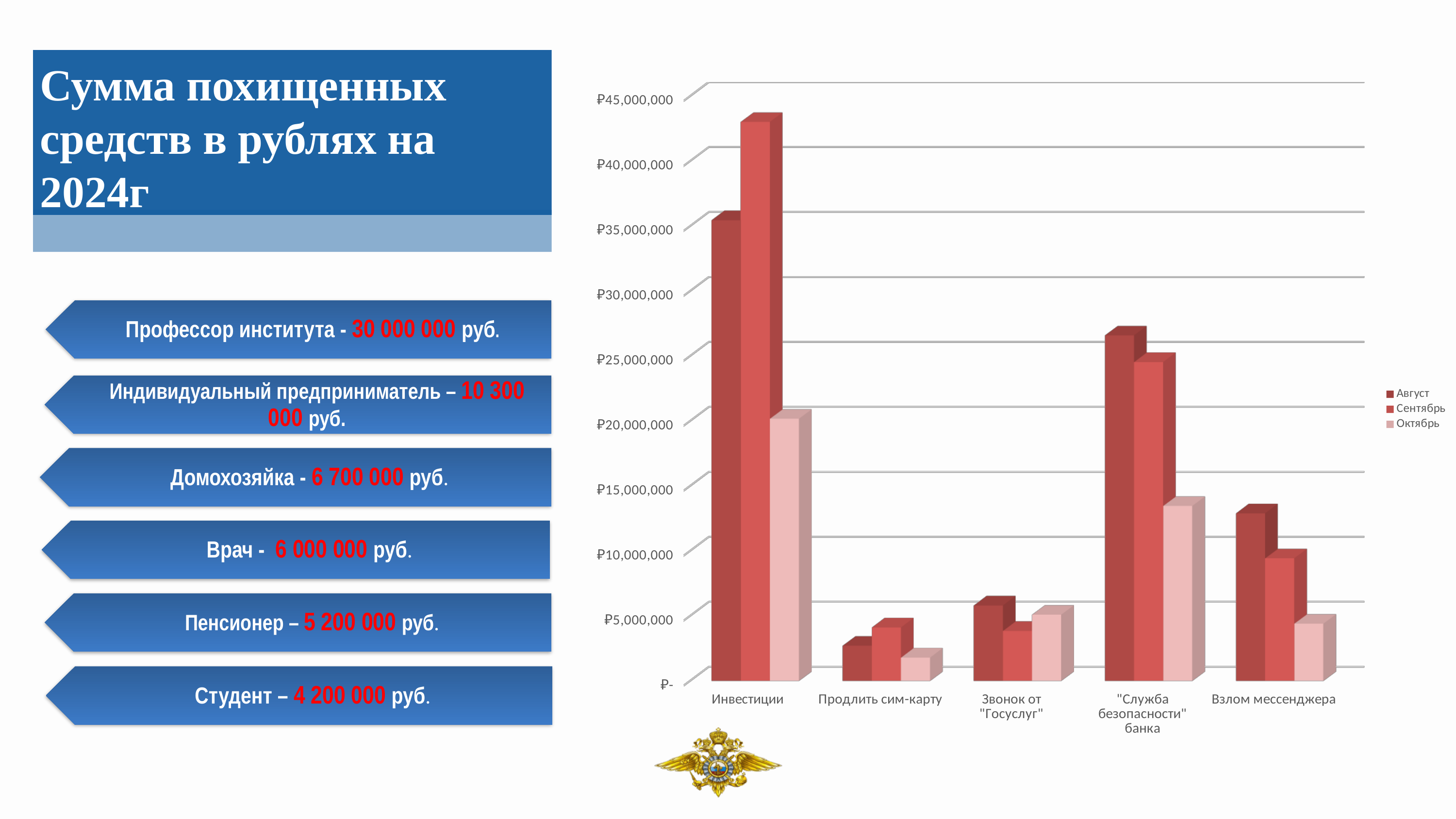
Which is larger: the Октябрь value for Инвестиции or the Октябрь value for "Служба безопасности" банка? Инвестиции Is the Сентябрь value for Инвестиции greater or less than ₽40,000,000? greater How many categories are shown on the x axis of the chart? 5 Is the Октябрь value for Инвестиции greater or less than ₽15,000,000? greater For Взлом мессенджера, which is larger: the Август value or the Сентябрь value? Август What are the three series listed in the chart legend? Август, Сентябрь, Октябрь Which category has the highest value for Сентябрь? Инвестиции Is the Август value for Взлом мессенджера greater or less than ₽10,000,000? greater How many series does the chart legend list? 3 What kind of chart is shown on the slide? bar chart Which category has the lowest value for Октябрь? Продлить сим-карту Which category has the lowest value for Август? Продлить сим-карту